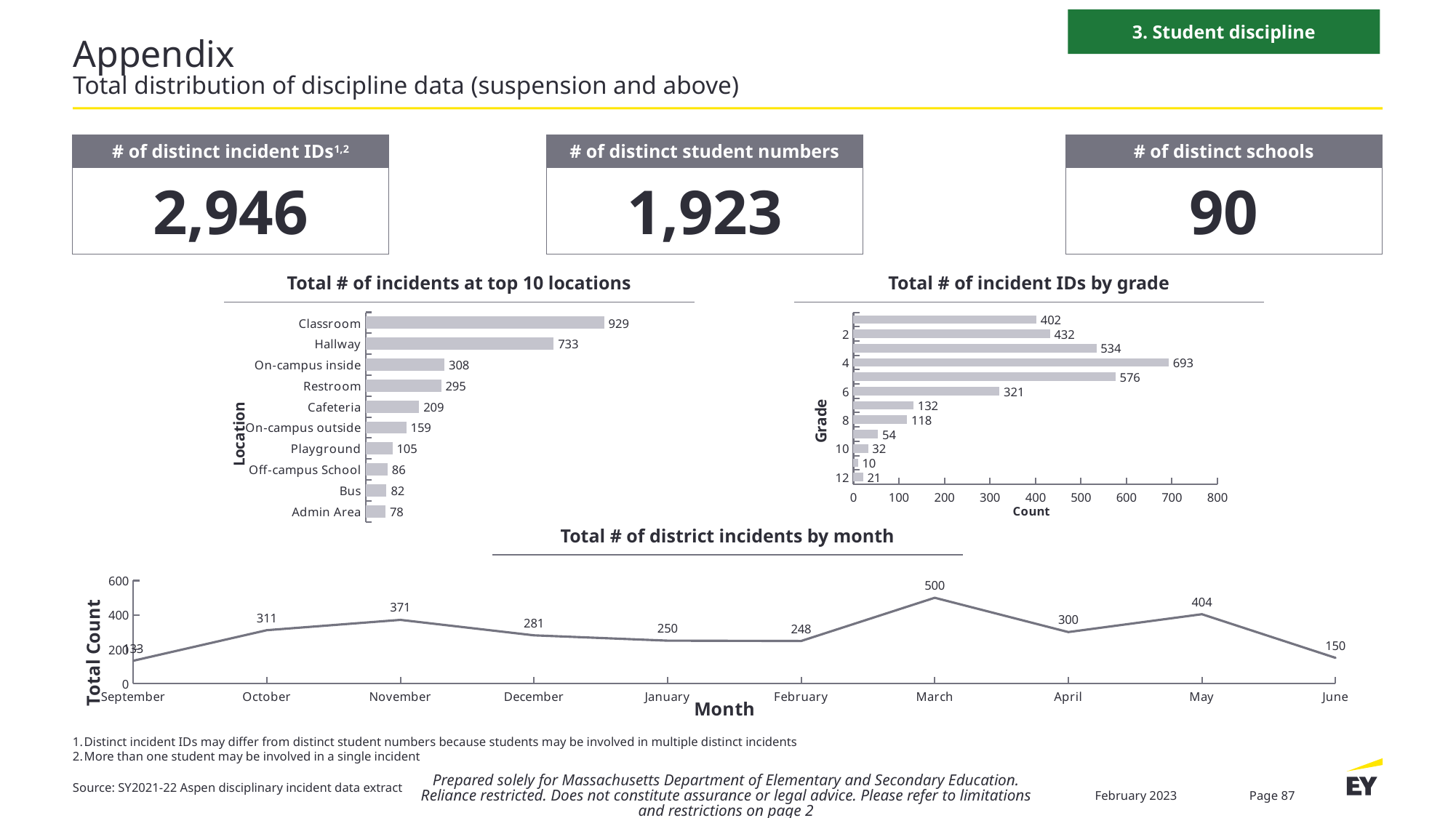
In the 'Total # of incident IDs by grade' chart, which grade has the highest number of incident IDs? 4 In the 'Total # of district incidents by month' chart, what is the total count for May? 404 How many locations are shown in the 'Total # of incidents at top 10 locations' chart? 10 In the 'Total # of district incidents by month' chart, which month has the highest total count? March In the 'Total # of incidents at top 10 locations' chart, how many incidents are shown for Classroom? 929 In the 'Total # of incidents at top 10 locations' chart, which has more incidents, Restroom or Cafeteria? Restroom In the 'Total # of incidents at top 10 locations' chart, what is the difference between Classroom and Hallway incidents? 196 In the 'Total # of incident IDs by grade' chart, how many incident IDs are shown for grade 4? 693 In the 'Total # of incidents at top 10 locations' chart, which location has the lowest number of incidents? Admin Area In the 'Total # of incident IDs by grade' chart, is the value for grade 6 greater or less than 300? greater What type of chart is 'Total # of incident IDs by grade'? Bar chart In the 'Total # of district incidents by month' chart, what is the difference between the March and April values? 200